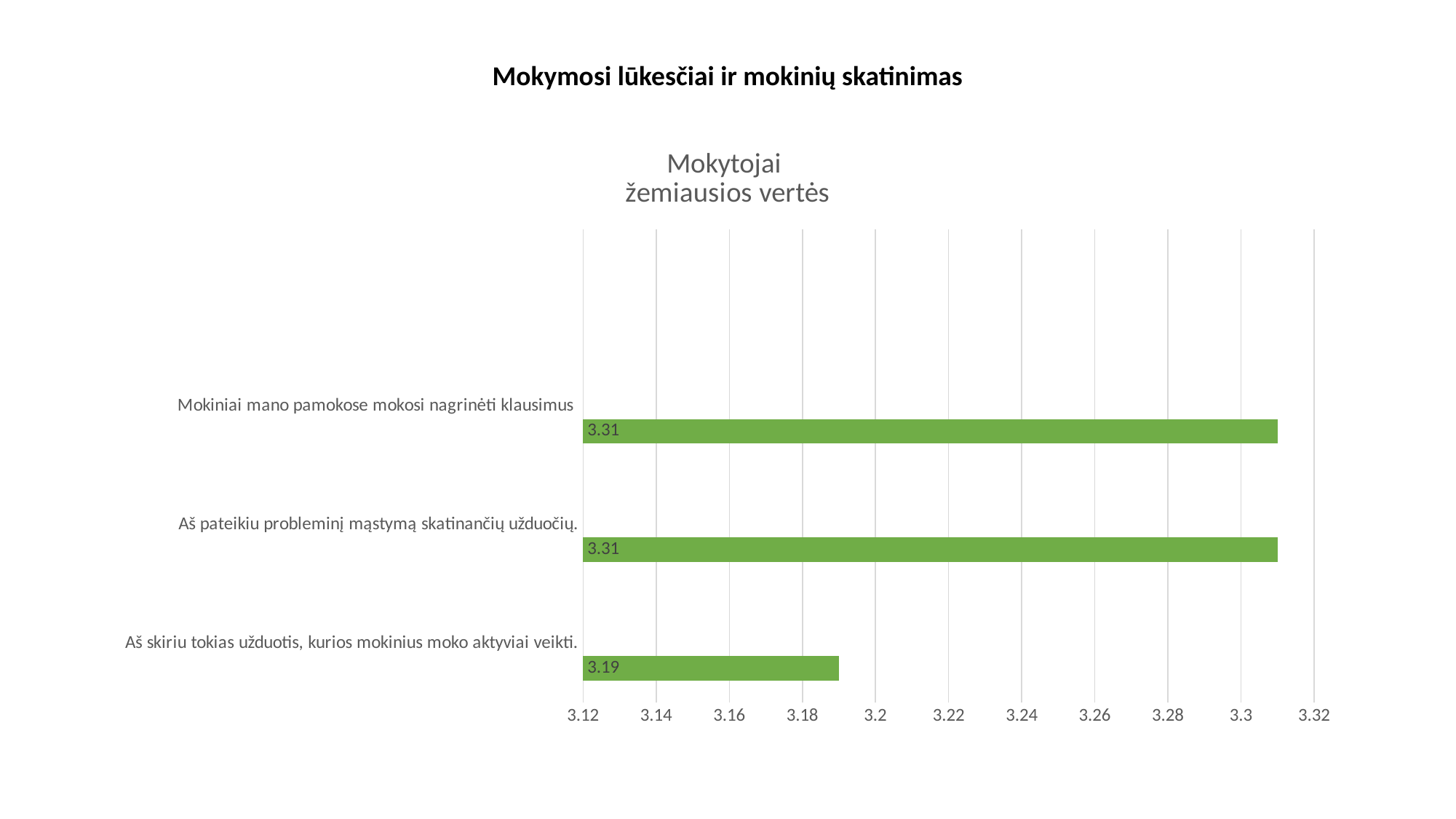
How many categories are shown in the chart? 3 Is the value for "Aš skiriu tokias užduotis, kurios mokinius moko aktyviai veikti." greater or less than 3.2? less What is the difference between the value for "Mokiniai mano pamokose mokosi nagrinėti klausimus" and the value for "Aš skiriu tokias užduotis, kurios mokinius moko aktyviai veikti."? 0.12 Which is larger: the value for "Aš pateikiu probleminį mąstymą skatinančių užduočių." or the value for "Aš skiriu tokias užduotis, kurios mokinius moko aktyviai veikti."? Aš pateikiu probleminį mąstymą skatinančių užduočių. What colour are the bars in the chart? green Is the value for "Mokiniai mano pamokose mokosi nagrinėti klausimus" greater or less than 3.3? greater What is the value for "Mokiniai mano pamokose mokosi nagrinėti klausimus"? 3.31 What kind of chart is shown on the slide? bar chart What is the value for "Aš skiriu tokias užduotis, kurios mokinius moko aktyviai veikti."? 3.19 What is the title of the chart? Mokytojai žemiausios vertės Which category has the lowest value? Aš skiriu tokias užduotis, kurios mokinius moko aktyviai veikti. What is the value for "Aš pateikiu probleminį mąstymą skatinančių užduočių."? 3.31